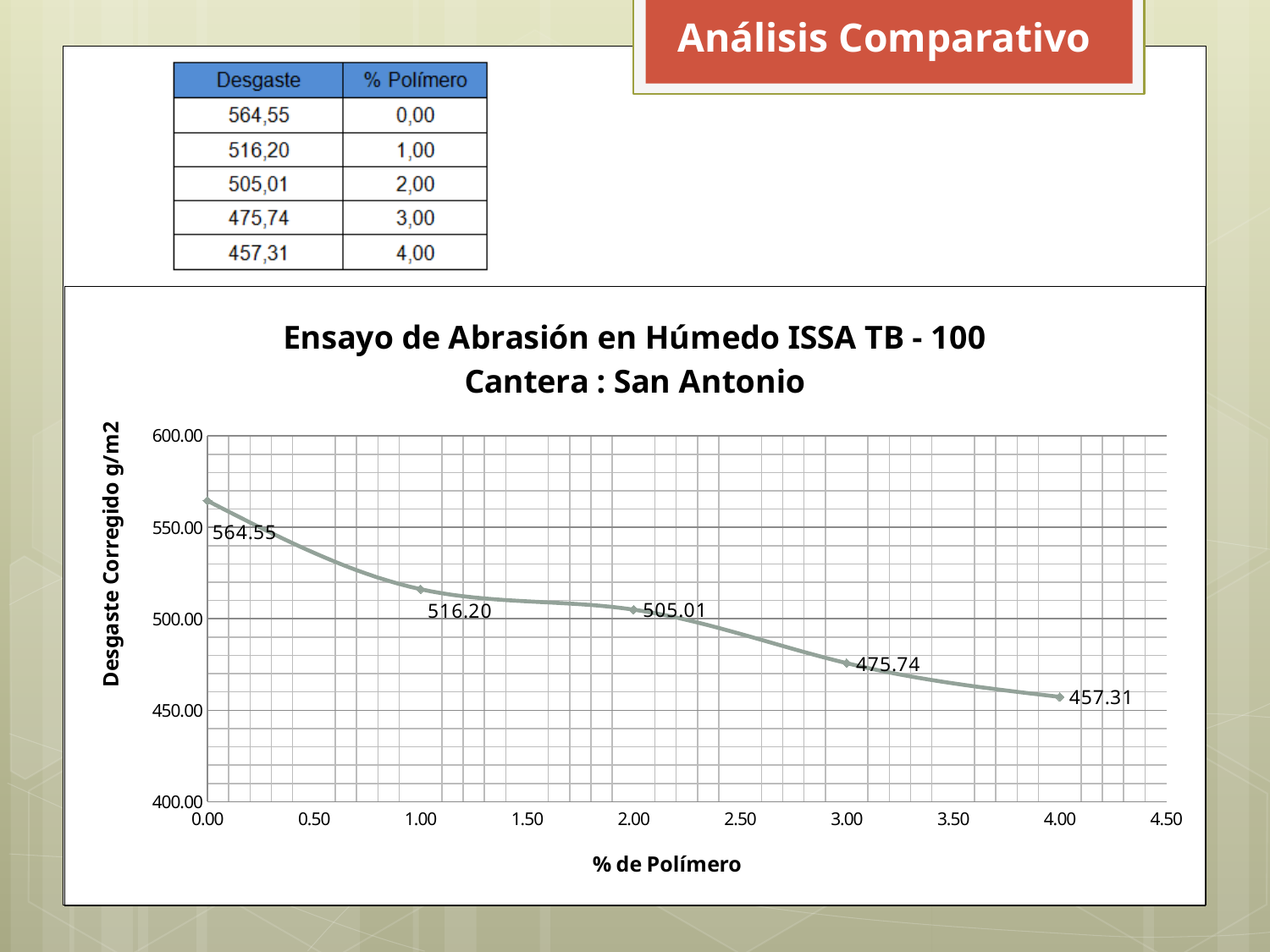
At which % de Polímero is the Desgaste Corregido highest? 0.00 What is the Desgaste Corregido value at 0.00 % de Polímero? 564.55 How many data points are plotted on the chart? 5 Which is larger, the Desgaste Corregido at 1.00 or at 3.00 % de Polímero? 1.00 What is the difference between the Desgaste Corregido at 0.00 and at 4.00 % de Polímero? 107.24 What is the Desgaste Corregido value at 4.00 % de Polímero? 457.31 At which % de Polímero is the Desgaste Corregido lowest? 4.00 What is the Desgaste Corregido value at 2.00 % de Polímero? 505.01 What is the difference between the Desgaste Corregido at 1.00 and at 2.00 % de Polímero? 11.19 What kind of chart is shown on the slide? line chart What is the Desgaste Corregido value at 3.00 % de Polímero? 475.74 Does the Desgaste Corregido rise or fall as % de Polímero increases? fall